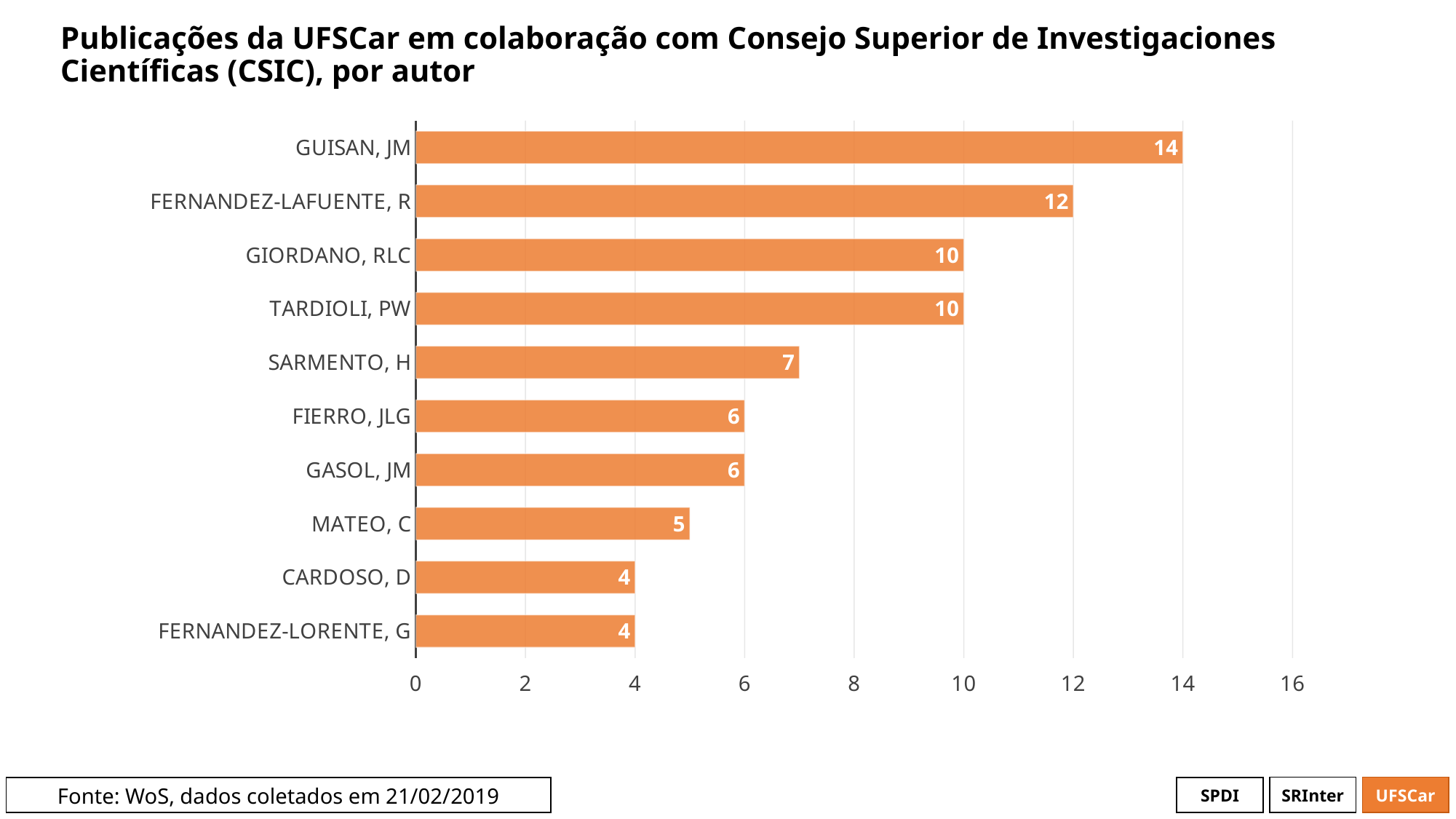
What is the source of the data cited on the slide? WoS, dados coletados em 21/02/2019 What is the value for FERNANDEZ-LORENTE, G? 4 Which author has the highest number of publications? GUISAN, JM How many authors are shown in the chart? 10 Which is larger, the value for FERNANDEZ-LAFUENTE, R or the value for TARDIOLI, PW? FERNANDEZ-LAFUENTE, R How many publications does GUISAN, JM have? 14 What is the value for SARMENTO, H? 7 What is the difference between the values for GUISAN, JM and FERNANDEZ-LAFUENTE, R? 2 What is the difference between the values for GIORDANO, RLC and CARDOSO, D? 6 What is the value for MATEO, C? 5 What kind of chart is shown on the slide? bar chart Is the value for FIERRO, JLG greater or less than 8? less